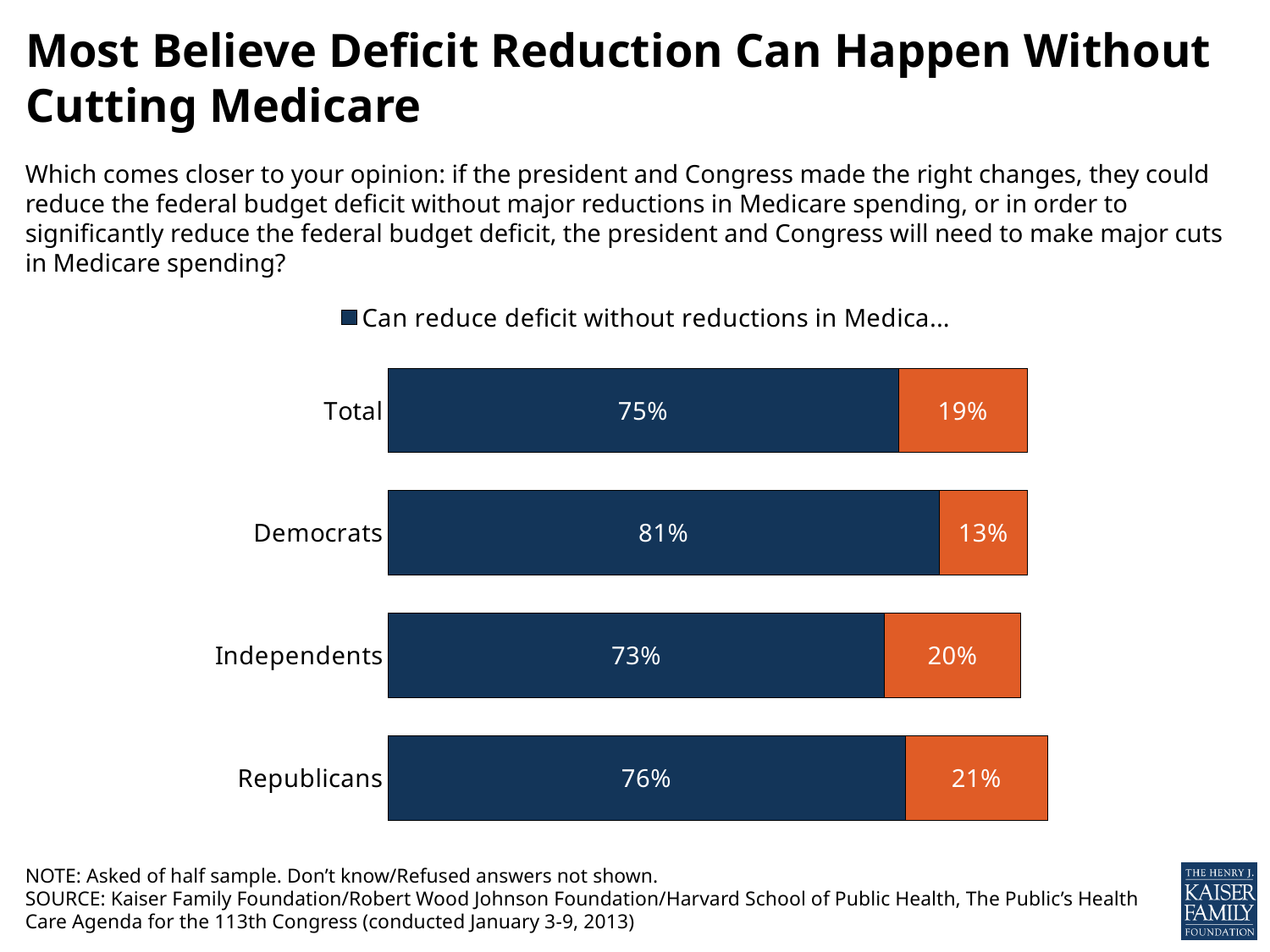
Which group has the smallest orange segment? Democrats Which group has the highest share saying the deficit can be reduced without reductions in Medicare? Democrats What percentage of Democrats say the deficit can be reduced without reductions in Medicare? 81% What kind of chart is shown on the slide? Stacked bar chart Which group has the lowest share saying the deficit can be reduced without reductions in Medicare? Independents How many percentage points higher is the dark blue value for Democrats than for Independents? 8 percentage points How many groups are shown on the chart? 4 What is the combined total of the two segments in the Total bar? 94% What is the value of the orange segment for Independents? 20% What is the legend entry shown above the chart? Can reduce deficit without reductions in Medica… What is the value of the orange segment for Republicans? 21% Which is larger, the dark blue value for Total or for Republicans? Republicans